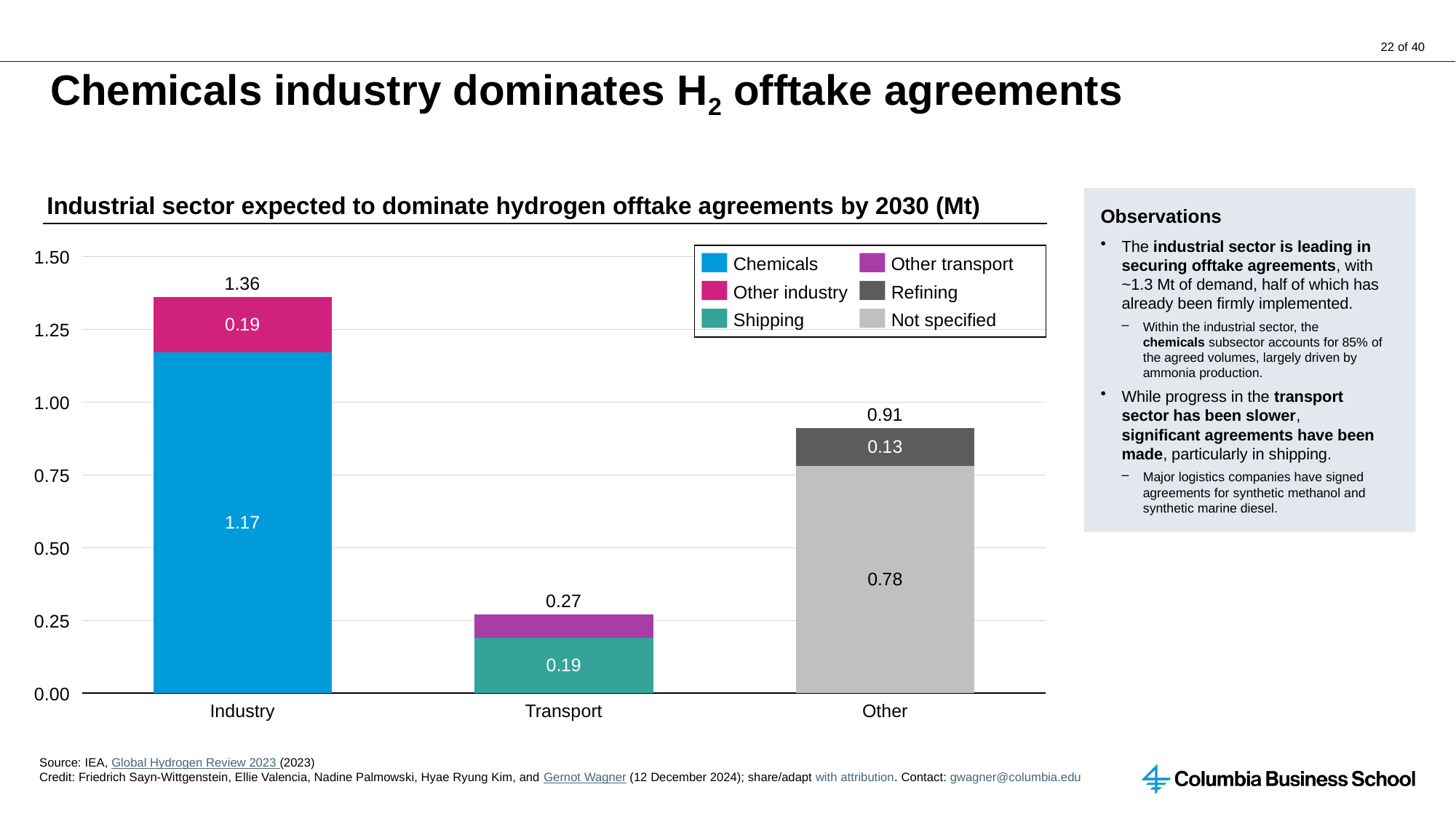
What is the value of the Chemicals segment in the Industry bar? 1.17 What is the difference between the Industry total (1.36) and the Other total (0.91)? 0.45 What is the value of the Refining segment in the Other bar? 0.13 How many series does the legend list? 6 What kind of chart is shown on the slide? Stacked bar chart Which category has the lowest total bar? Transport What is the value of the Not specified segment in the Other bar? 0.78 What is the value of the Shipping segment in the Transport bar? 0.19 What is the total of the Industry stacked bar? 1.36 Which category has the highest total bar? Industry Is the total for Transport greater or less than 0.50? less What is the value of the Other industry segment in the Industry bar? 0.19